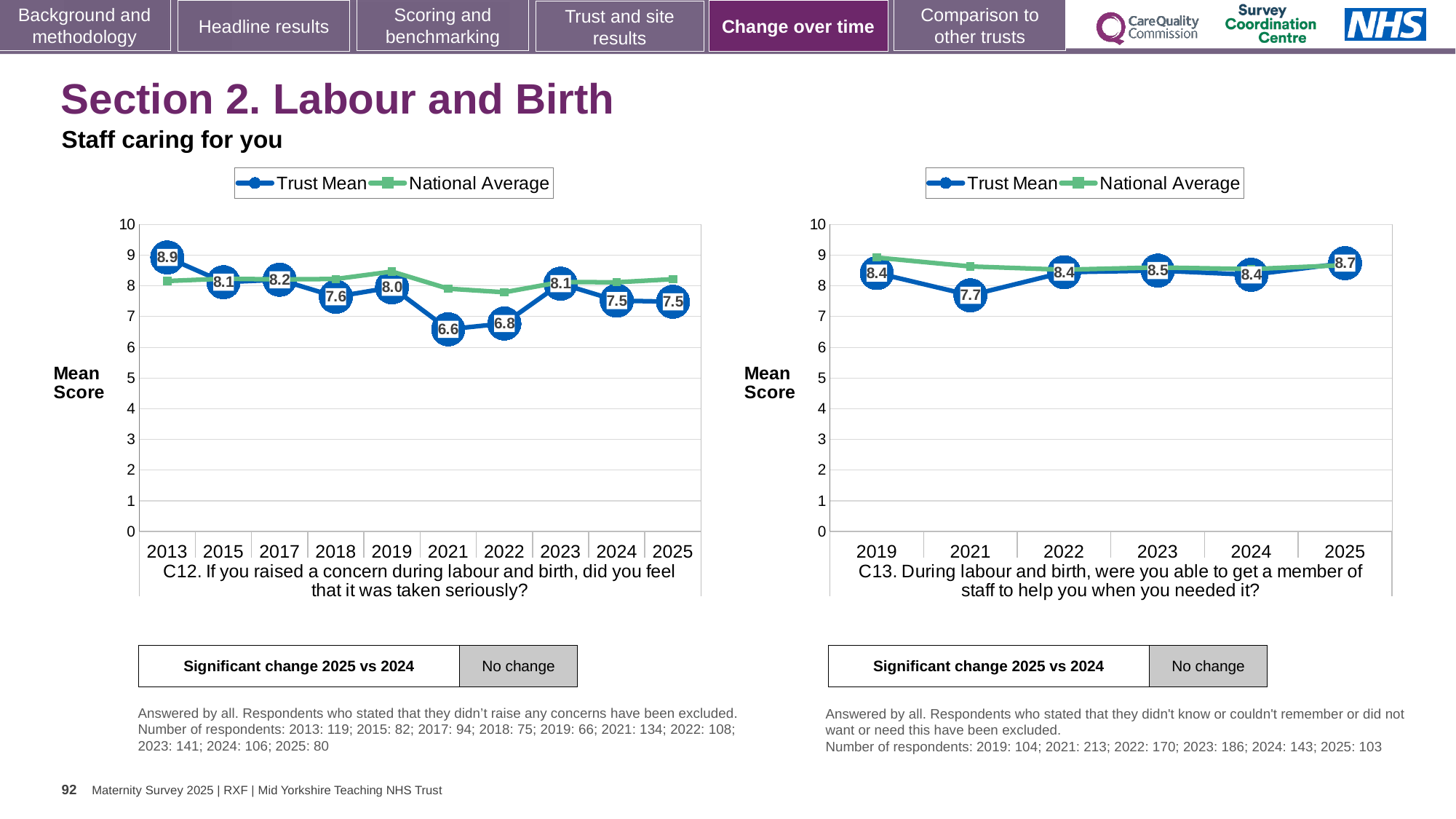
In the C12 chart on the left, is the Trust Mean score for 2022 higher or lower than for 2023? lower How many series does the legend of the C12 chart on the left list? 2 In the C13 chart on the right, what is the difference between the Trust Mean scores for 2025 and 2021? 1.0 In the C12 chart on the left, what is the Trust Mean score for 2021? 6.6 How many years are plotted on the x axis of the C13 chart on the right? 6 In the C13 chart on the right, which year has the lowest Trust Mean score? 2021 What type of chart is the C13 chart on the right? line chart In the C12 chart on the left, what is the Trust Mean score for 2013? 8.9 In the C13 chart on the right, what is the Trust Mean score for 2025? 8.7 In the C12 chart on the left, is the National Average for 2021 greater or less than 7? greater In the C12 chart on the left, which year has the highest Trust Mean score? 2013 In the C12 chart on the left, what is the difference between the Trust Mean scores for 2013 and 2021? 2.3